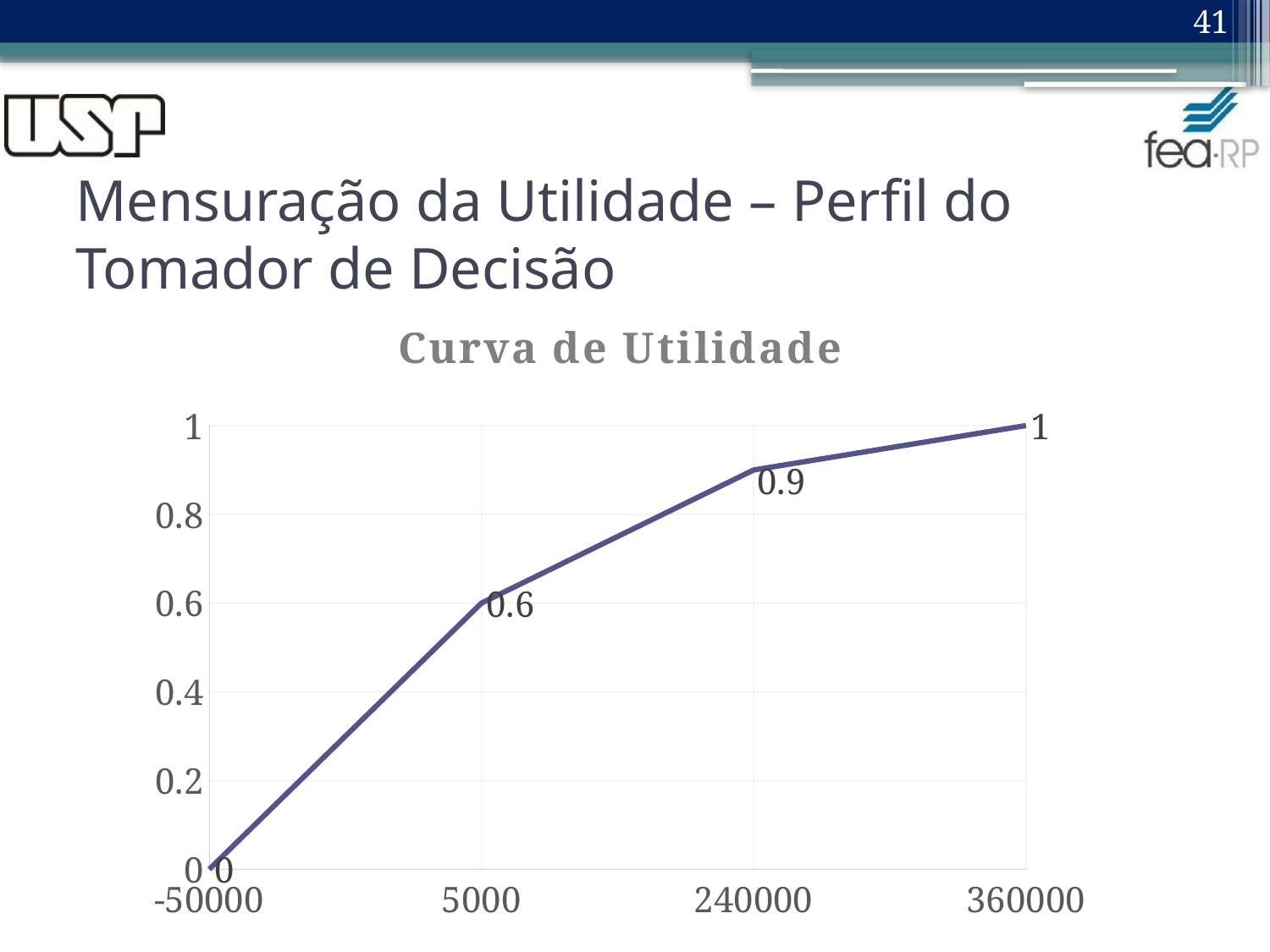
How many data points are plotted on the curve? 4 Do the utility values rise or fall as the x-axis values increase? rise At which x-axis value is the utility lowest? -50000 What kind of chart is shown on the slide? line chart What is the utility value at -50000? 0 What is the utility value at 360000? 1 What is the difference between the utility at 240000 and the utility at 5000? 0.3 Which has a higher utility value, 5000 or 240000? 240000 What is the title of the chart? Curva de Utilidade What is the utility value at 240000? 0.9 What is the utility value at 5000? 0.6 At which x-axis value is the utility highest? 360000